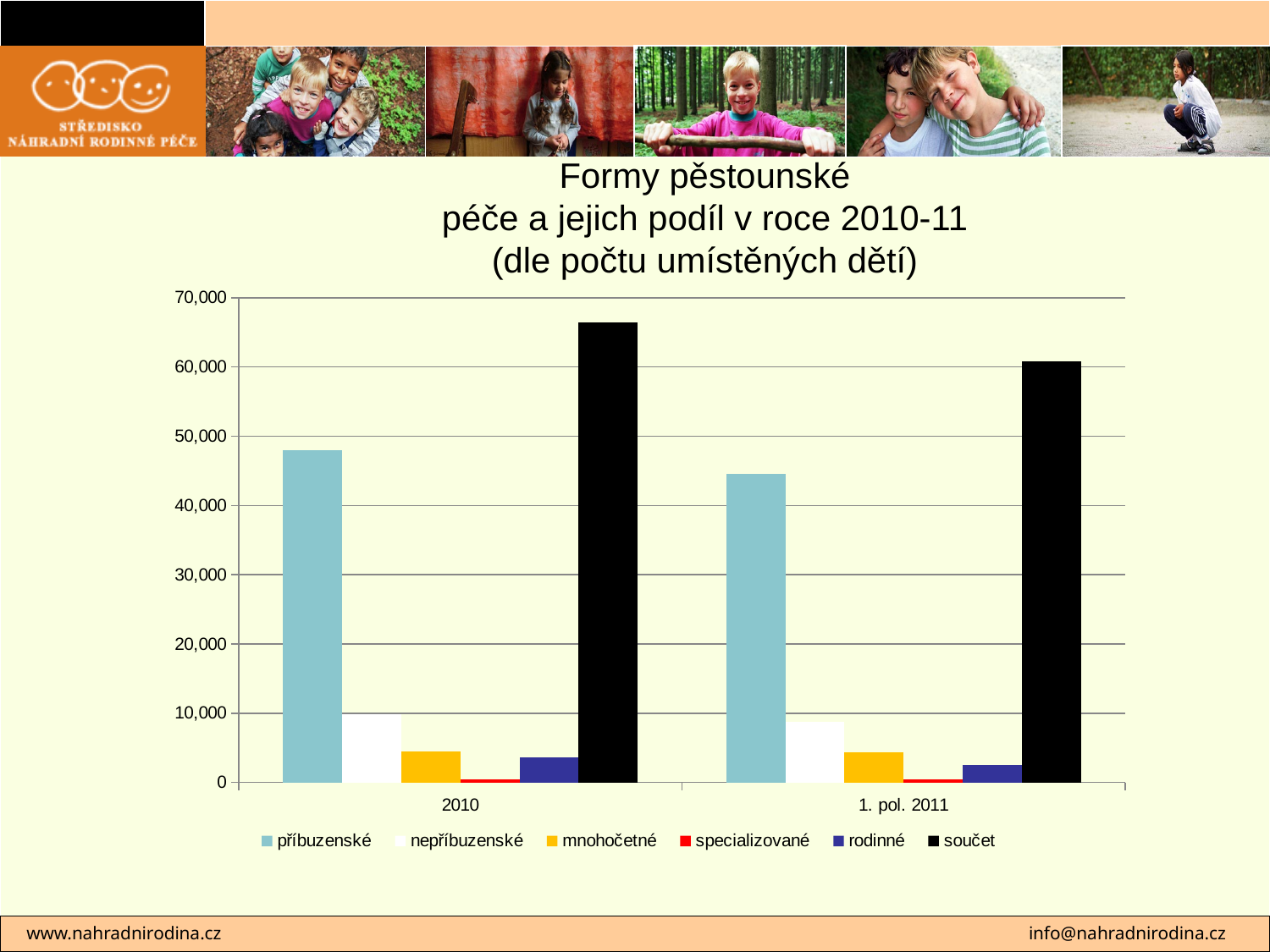
Is the value for nepříbuzenské in 1. pol. 2011 greater or less than 10,000? less Does the value for příbuzenské rise or fall from 2010 to 1. pol. 2011? fall Which is larger: mnohočetné in 2010 or rodinné in 2010? mnohočetné in 2010 How many categories are shown on the x axis of the chart? 2 How many series does the chart legend list? 6 Which series has the lowest value in 1. pol. 2011? specializované Which series has the highest value in 2010? součet What kind of chart is shown on the slide? bar chart What colour are the bars for the součet series? black Is the value for příbuzenské in 2010 greater or less than 40,000? greater Which is larger: součet in 2010 or součet in 1. pol. 2011? součet in 2010